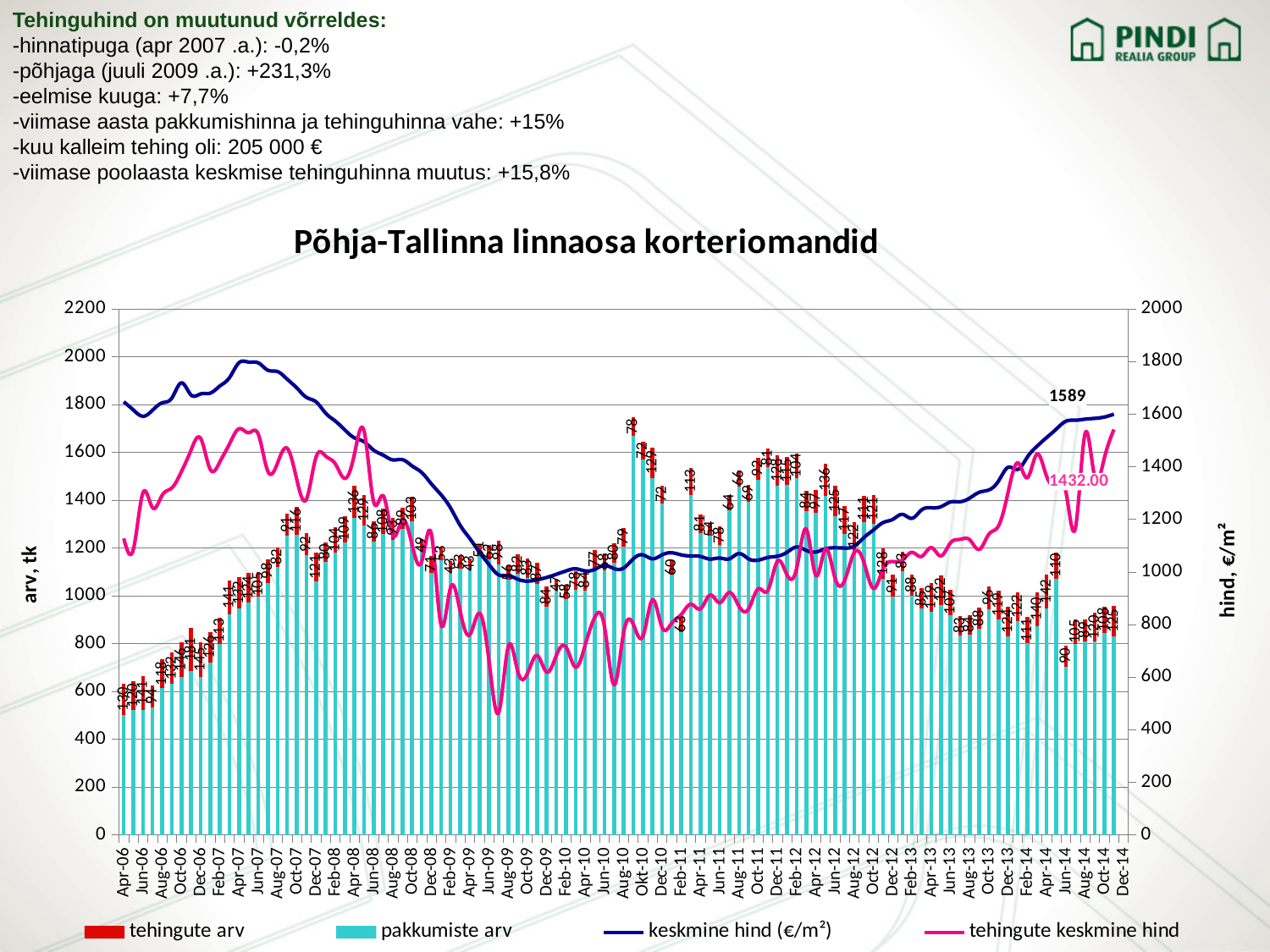
At Apr-07, which line is higher: keskmine hind (€/m²) or tehingute keskmine hind? keskmine hind (€/m²) Does the keskmine hind (€/m²) line rise or fall between Dec-12 and Dec-14? Rise What kind of chart is shown on the slide? Combined bar and line chart How many series does the chart legend list? 4 What is the labelled value shown on the tehingute keskmine hind line near the end of the chart? 1432.00 What is the title of the chart? Põhja-Tallinna linnaosa korteriomandid What is the label of the right-hand vertical axis? hind, €/m² Is the keskmine hind (€/m²) value at Apr-07 greater or less than 1600 on the right axis? greater Does the keskmine hind (€/m²) line rise or fall between Apr-07 and Jun-09? Fall What is the labelled value of the keskmine hind (€/m²) line near the end of the chart? 1589